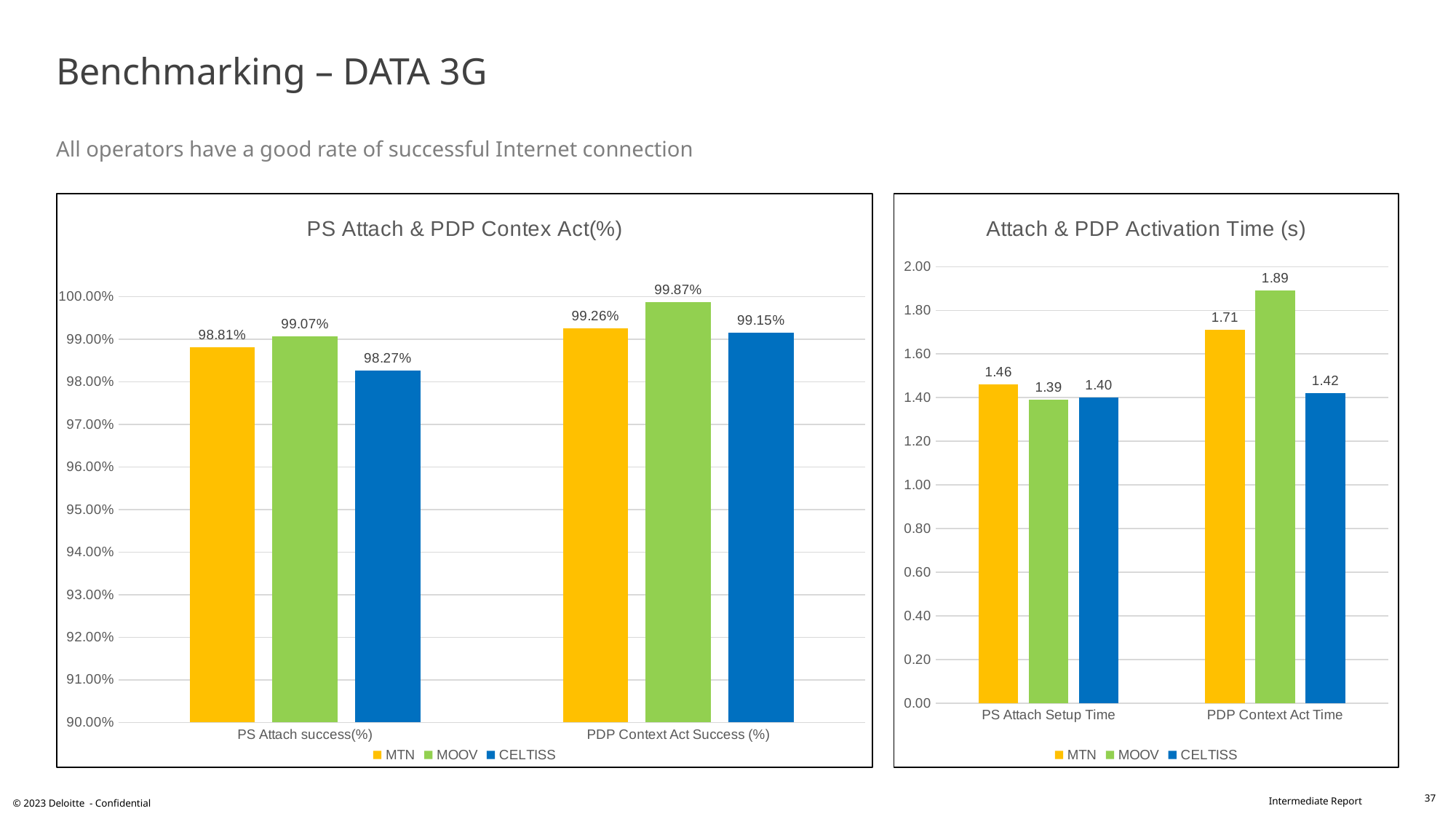
In the 'PS Attach & PDP Contex Act(%)' chart, what is the difference between MOOV's and MTN's PS Attach success(%)? 0.26% In the 'PS Attach & PDP Contex Act(%)' chart, what is the value for CELTISS in PDP Context Act Success (%)? 99.15% In the 'PS Attach & PDP Contex Act(%)' chart, how many series does the legend list? 3 What kind of chart is the 'Attach & PDP Activation Time (s)' chart? Bar chart In the 'PS Attach & PDP Contex Act(%)' chart, which operator has the lowest PS Attach success(%)? CELTISS In the 'PS Attach & PDP Contex Act(%)' chart, which operator has the highest PDP Context Act Success (%)? MOOV In the 'Attach & PDP Activation Time (s)' chart, what is the PDP Context Act Time for MOOV? 1.89 In the 'Attach & PDP Activation Time (s)' chart, which operator has the lowest PS Attach Setup Time? MOOV In the 'Attach & PDP Activation Time (s)' chart, is MTN's PDP Context Act Time greater or less than CELTISS's? greater In the 'Attach & PDP Activation Time (s)' chart, what is the PS Attach Setup Time for MTN? 1.46 In the 'Attach & PDP Activation Time (s)' chart, what is the difference between MOOV's and CELTISS's PDP Context Act Time? 0.47 In the 'PS Attach & PDP Contex Act(%)' chart, what is the value for MOOV in PS Attach success(%)? 99.07%